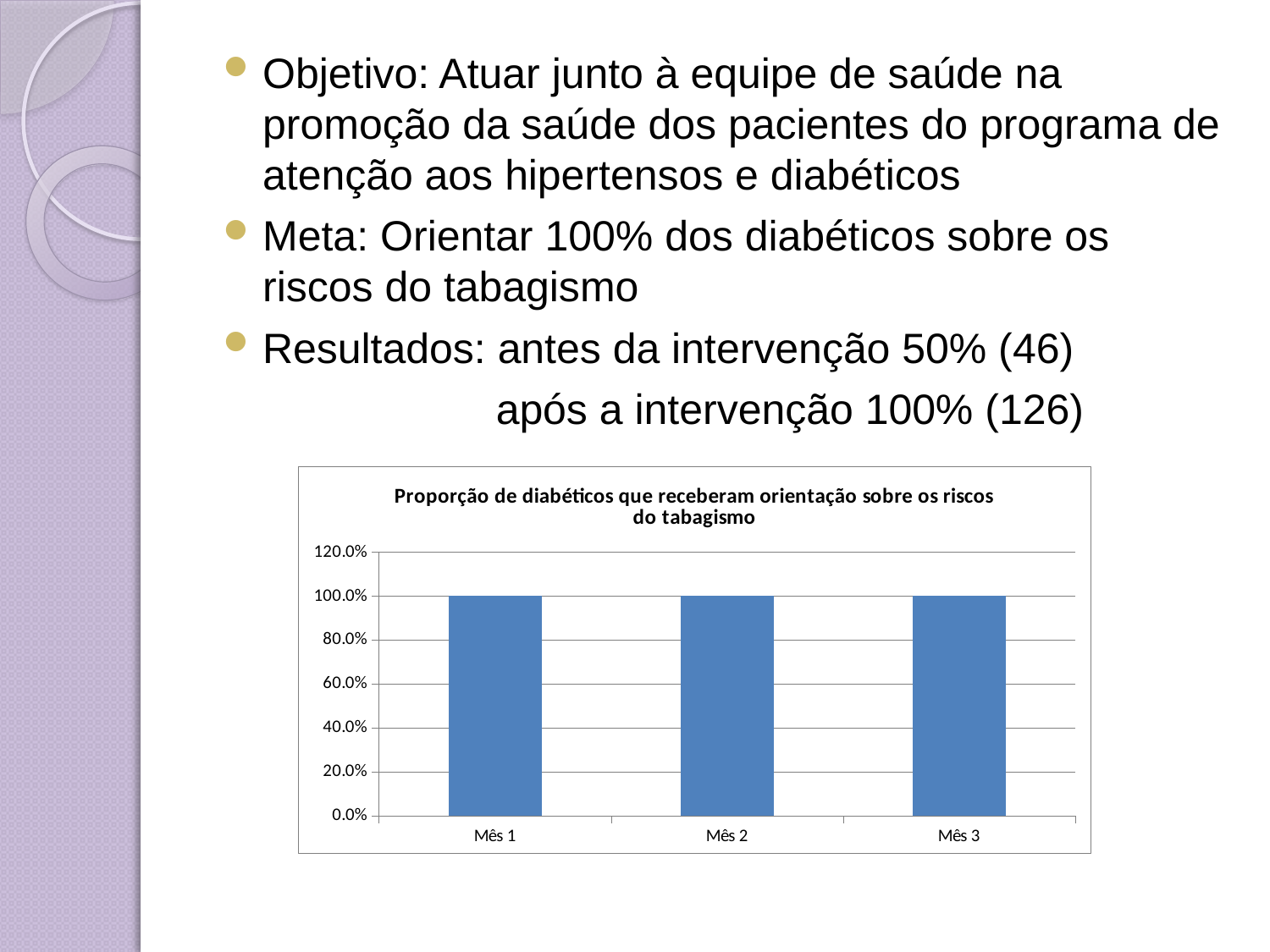
Is the value for Mês 3 greater or less than 120.0%? less What is the label of the first category on the x axis? Mês 1 What type of chart is shown on the slide? bar chart What is the value for Mês 3? 100.0% What is the value for Mês 1? 100.0% What is the value for Mês 2? 100.0% Do the values rise, fall, or stay the same from Mês 1 to Mês 3? stay the same What is the title of the chart? Proporção de diabéticos que receberam orientação sobre os riscos do tabagismo What is the difference between the values for Mês 1 and Mês 3? 0.0% What is the highest value shown on the y axis of the chart? 120.0% How many categories are shown on the x axis of the chart? 3 Is the value for Mês 1 greater or less than 80.0%? greater